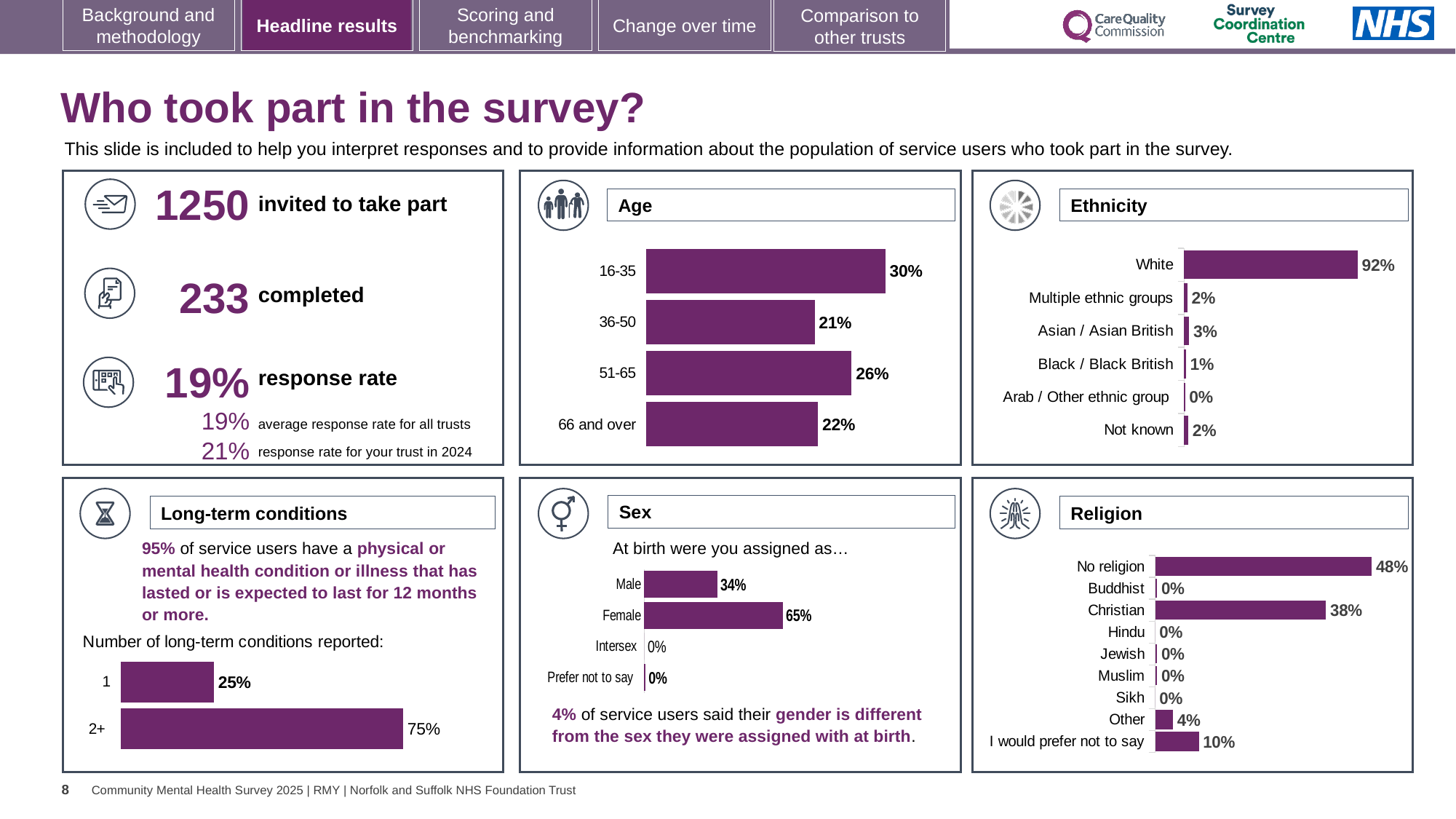
In the Sex chart, what percentage of respondents were assigned Female at birth? 65% In the Age chart, what is the difference between the 51-65 and 66 and over percentages? 4% In the Ethnicity chart, how many ethnicity categories are shown? 6 In the Ethnicity chart, what percentage of respondents were White? 92% In the Religion chart, what is the difference between No religion and Christian? 10% In the Age chart, what percentage of respondents were aged 16-35? 30% In the Long-term conditions chart, what percentage of respondents reported 2+ long-term conditions? 75% In the Sex chart, which is larger, Male or Female? Female In the Religion chart, what percentage of respondents said they had no religion? 48% In the Ethnicity chart, which category has the highest percentage? White In the Age chart, which age group has the lowest percentage? 36-50 What type of chart is used in the Age panel? Bar chart